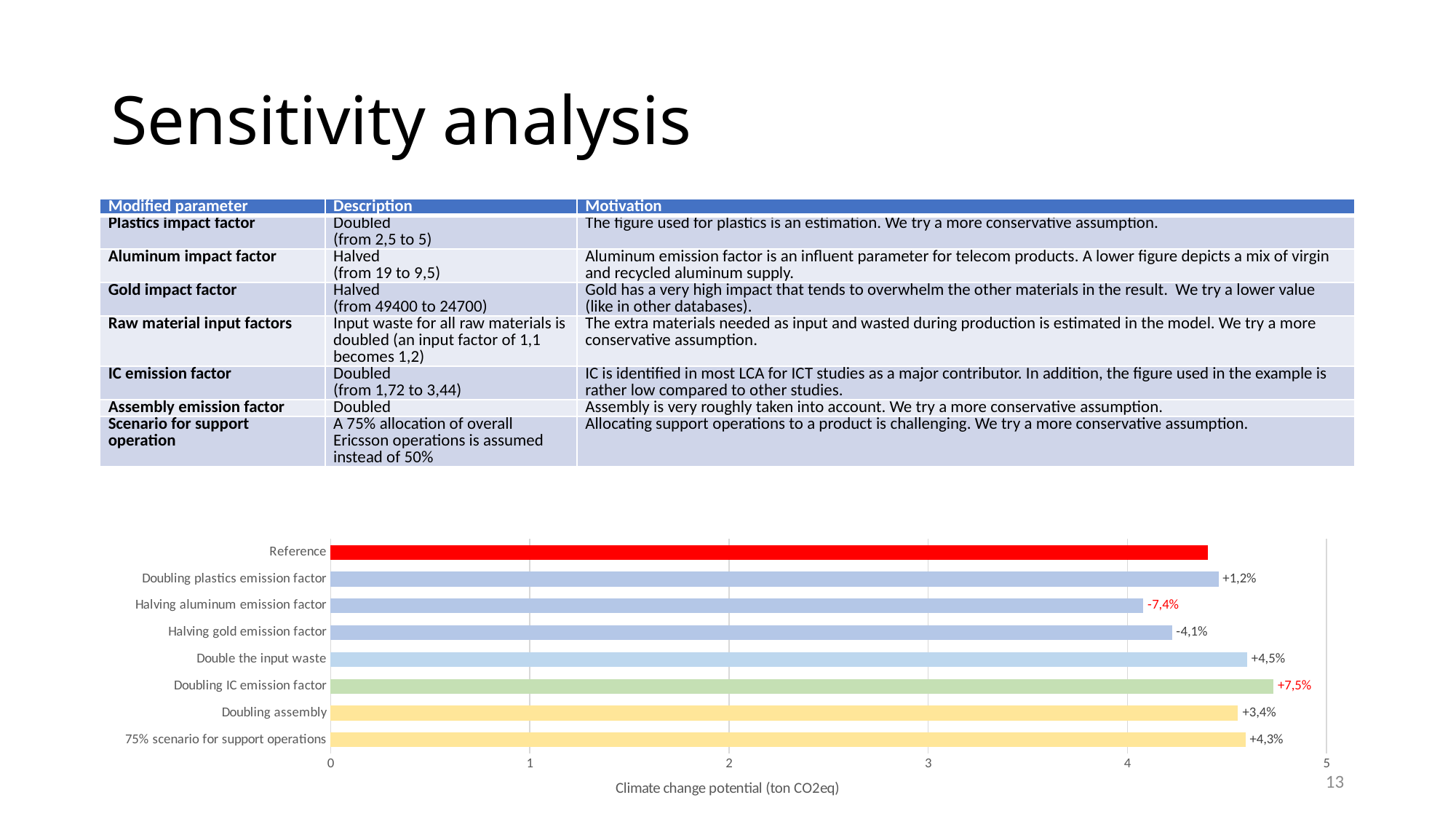
What percentage change is labelled on the bar for 'Halving aluminum emission factor'? -7,4% What kind of chart is shown on the slide? bar chart What is the title of the horizontal axis of the chart? Climate change potential (ton CO2eq) Is the value for 'Halving gold emission factor' greater or less than 4? greater How many bars (categories) does the chart show? 8 Which category has the shortest bar in the chart? Halving aluminum emission factor What percentage change is labelled on the bar for 'Halving gold emission factor'? -4,1% What percentage change is labelled on the bar for 'Doubling plastics emission factor'? +1,2% What percentage change is labelled on the bar for 'Doubling IC emission factor'? +7,5% Which category has the longest bar in the chart? Doubling IC emission factor Is the value for 'Doubling IC emission factor' greater or less than 5? less What percentage change is labelled on the bar for '75% scenario for support operations'? +4,3%